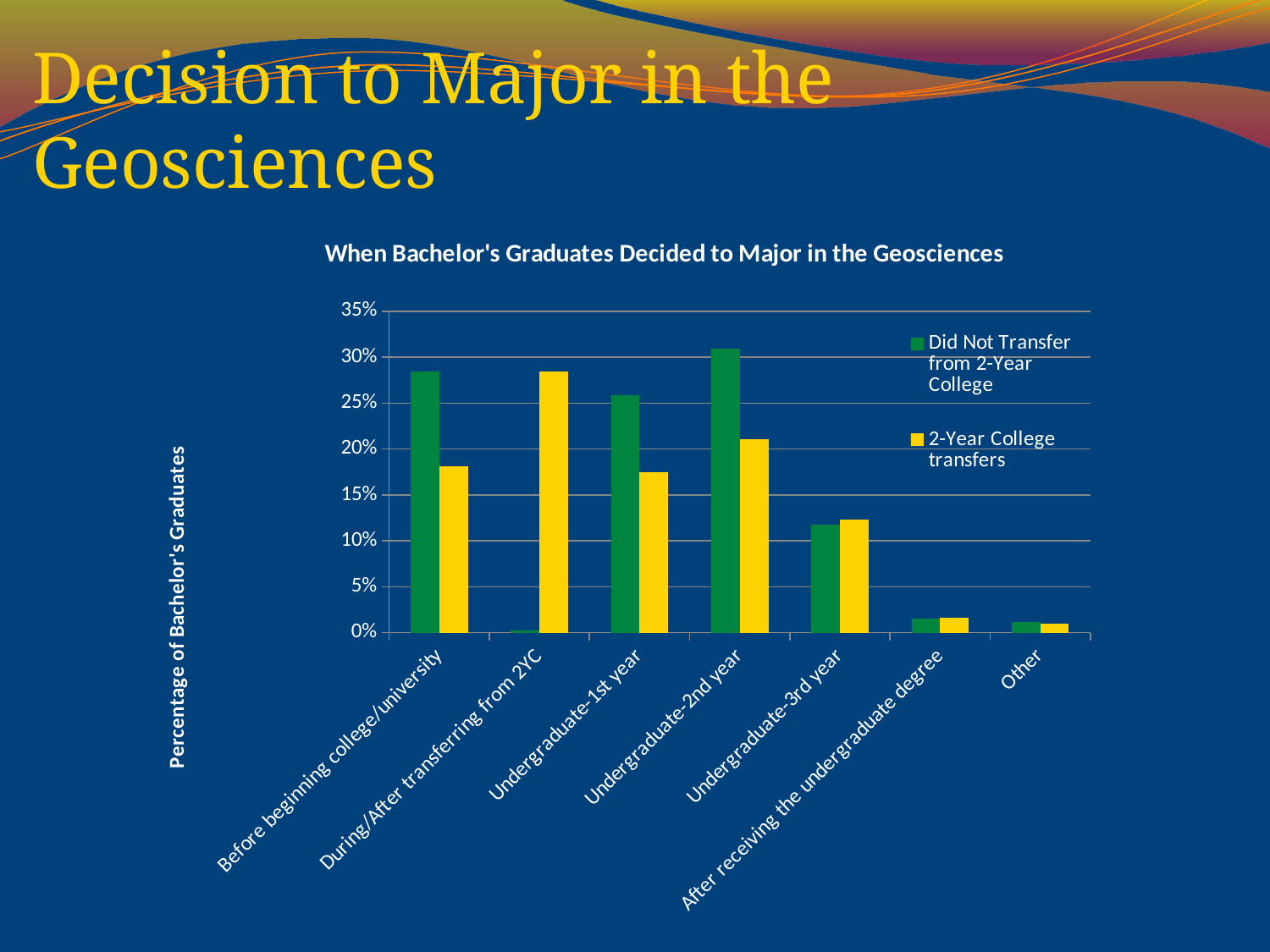
For the 'Did Not Transfer from 2-Year College' series, which category has the lowest value? During/After transferring from 2YC For Before beginning college/university, which series has the larger value: 'Did Not Transfer from 2-Year College' or '2-Year College transfers'? Did Not Transfer from 2-Year College For the '2-Year College transfers' series, which category has the highest value? During/After transferring from 2YC What is the title of the chart? When Bachelor's Graduates Decided to Major in the Geosciences For the 'Did Not Transfer from 2-Year College' series, which category has the highest value? Undergraduate-2nd year For During/After transferring from 2YC, which series has the larger value: 'Did Not Transfer from 2-Year College' or '2-Year College transfers'? 2-Year College transfers How many categories are shown on the x axis? 7 What kind of chart is shown on the slide? bar chart How many series does the legend list? 2 Is the '2-Year College transfers' value for During/After transferring from 2YC greater or less than 25%? greater Is the 'Did Not Transfer from 2-Year College' value for Undergraduate-2nd year greater or less than 25%? greater Is the '2-Year College transfers' value for Before beginning college/university greater or less than 20%? less